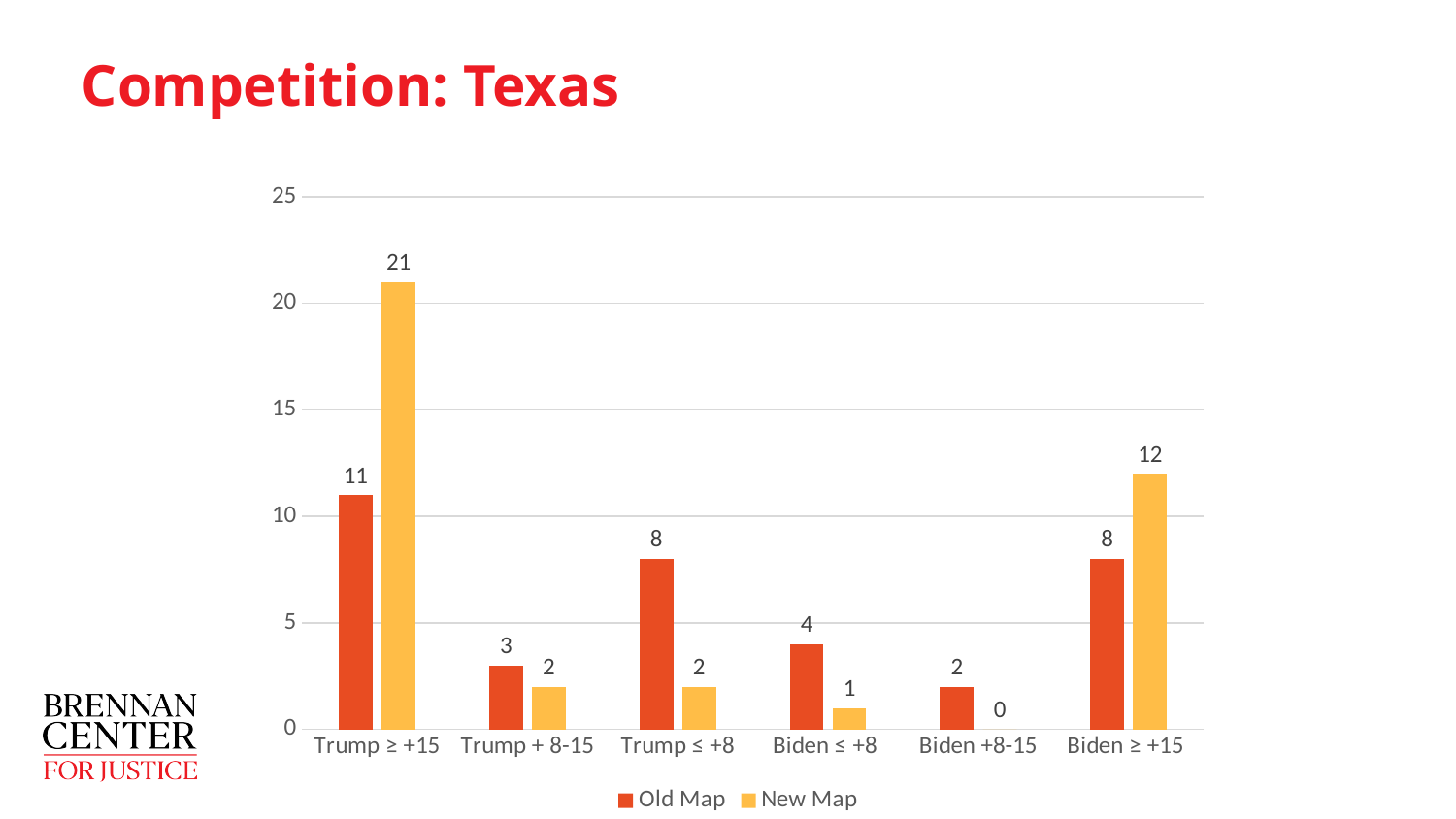
Is the New Map value for Biden ≥ +15 greater or less than 10? greater What is the New Map value for Trump ≥ +15? 21 Which is larger for Trump ≤ +8, the Old Map value or the New Map value? Old Map What is the Old Map value for Biden ≤ +8? 4 What is the New Map value for Biden +8-15? 0 What is the difference between the New Map and Old Map values for Trump ≥ +15? 10 Which category has the highest New Map value? Trump ≥ +15 Which category has the lowest Old Map value? Biden +8-15 What is the title of the slide? Competition: Texas How many series does the legend list? 2 How many categories are shown on the x axis? 6 What kind of chart is shown on the slide? bar chart